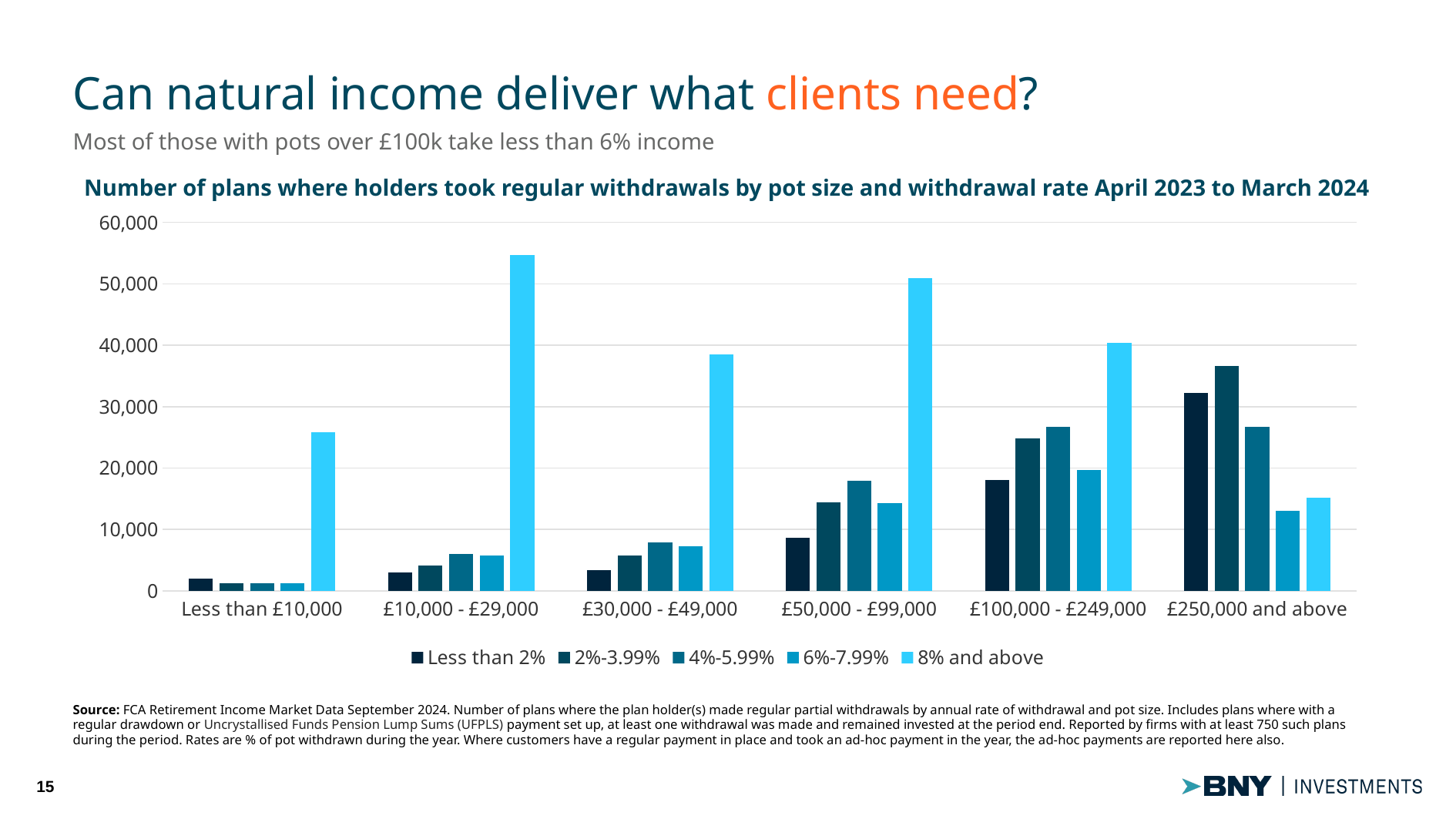
For the '8% and above' series, which is larger: '£50,000 - £99,000' or '£100,000 - £249,000'? £50,000 - £99,000 Which pot size category has the highest bar for the '8% and above' series? £10,000 - £29,000 Which pot size category has the lowest bar for the '8% and above' series? £250,000 and above In the '£250,000 and above' category, which is larger: the 'Less than 2%' bar or the '8% and above' bar? Less than 2% Within the '£250,000 and above' category, which withdrawal rate series has the highest bar? 2%-3.99% What is the title of the chart? Number of plans where holders took regular withdrawals by pot size and withdrawal rate April 2023 to March 2024 Is the '8% and above' value for 'Less than £10,000' greater or less than 20,000? greater Is the '8% and above' value for '£10,000 - £29,000' greater or less than 50,000? greater What kind of chart is shown on the slide? Bar chart How many withdrawal rate series does the legend list? 5 Is the 'Less than 2%' value for '£250,000 and above' greater or less than 30,000? greater How many pot size categories are shown on the x axis? 6